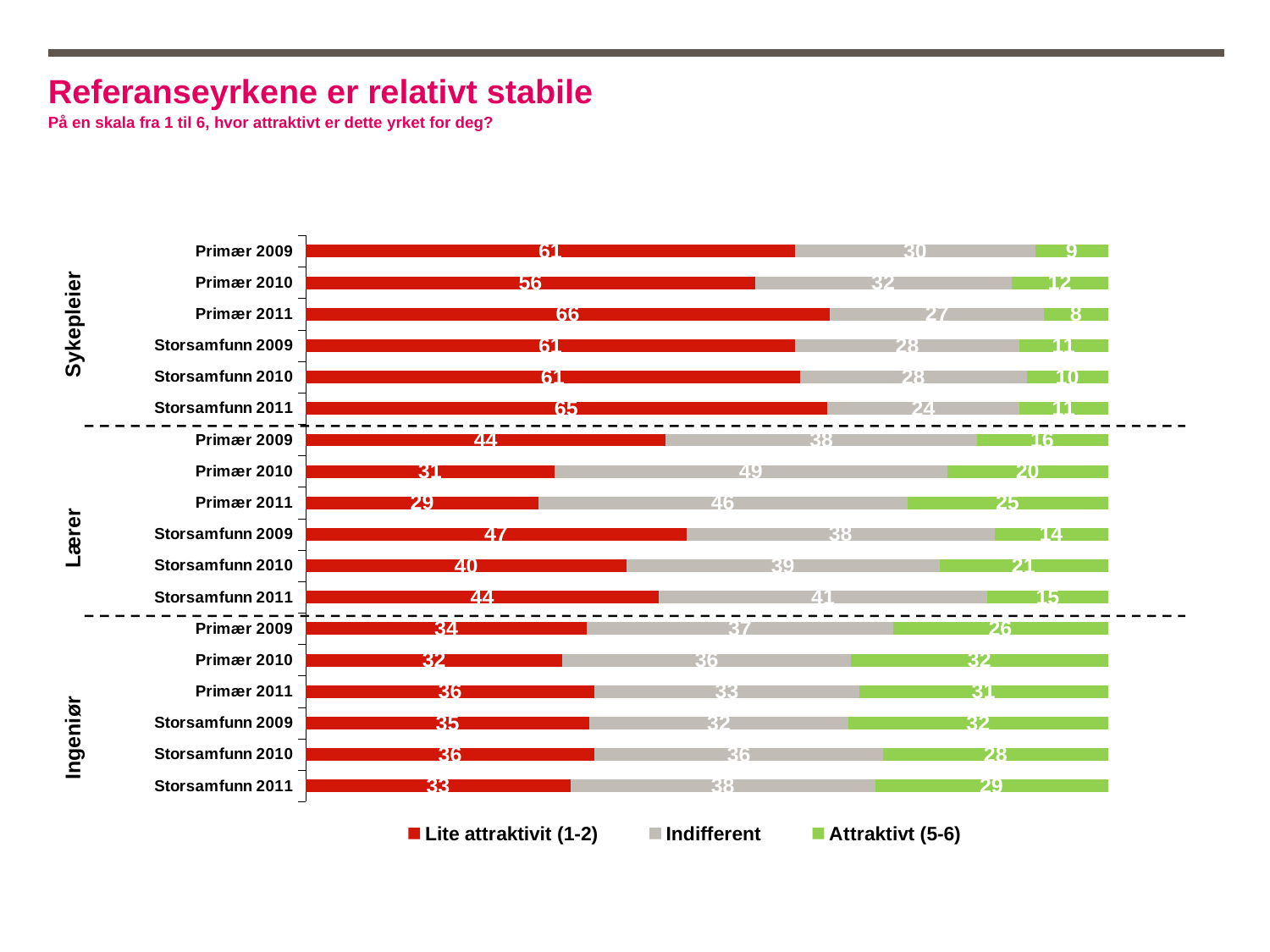
For Lærer, Primær 2010, which is larger: the Indifferent value or the Lite attraktivit (1-2) value? Indifferent How many series does the legend list? 3 Which bar has the highest Lite attraktivit (1-2) value? Sykepleier, Primær 2011 What is the Indifferent value for Lærer, Primær 2010? 49 What is the total of the stacked bar for Sykepleier, Primær 2009? 100 What is the Lite attraktivit (1-2) value for Sykepleier, Primær 2011? 66 Which bar has the lowest Attraktivt (5-6) value? Sykepleier, Primær 2011 What is the difference between the Lite attraktivit (1-2) value for Sykepleier Primær 2011 and for Lærer Primær 2011? 37 What kind of chart is shown on the slide? Stacked bar chart How many bars are plotted in the chart in total? 18 For Lærer, does the Lite attraktivit (1-2) value rise or fall across Primær 2009, 2010 and 2011? Fall What is the Attraktivt (5-6) value for Ingeniør, Storsamfunn 2011? 29